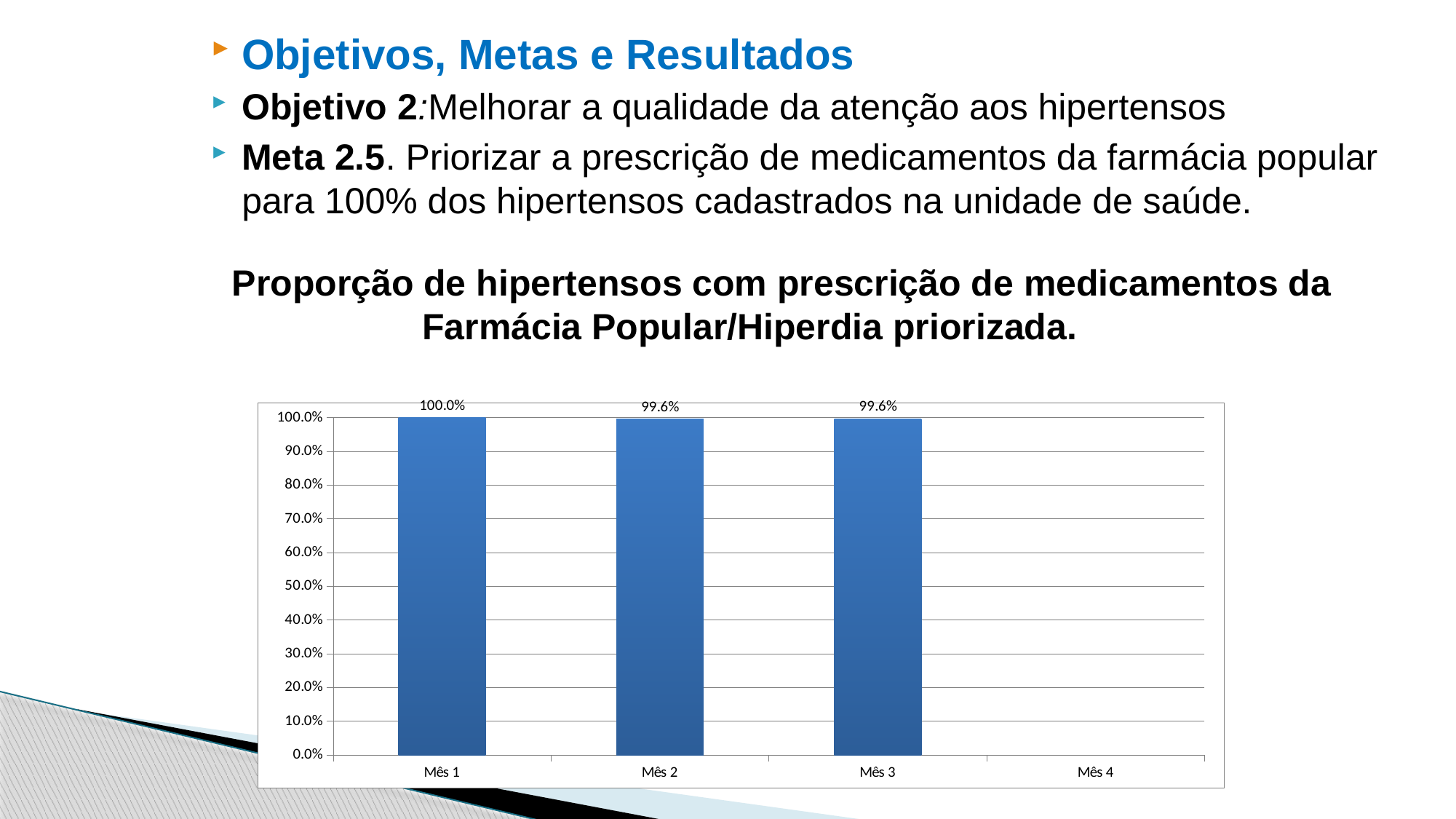
Which month has the highest value? Mês 1 How many categories are shown on the x axis? 4 Which month on the x axis has no bar plotted? Mês 4 What kind of chart is shown on the slide? bar chart What is the value for Mês 3? 99.6% What is the title of the chart? Proporção de hipertensos com prescrição de medicamentos da Farmácia Popular/Hiperdia priorizada. What is the value for Mês 2? 99.6% What is the difference between the values for Mês 1 and Mês 2? 0.4% Which is larger, the value for Mês 1 or the value for Mês 3? Mês 1 What is the value for Mês 1? 100.0% Do the values rise or fall from Mês 1 to Mês 2? fall Is the value for Mês 2 greater or less than 90.0%? greater